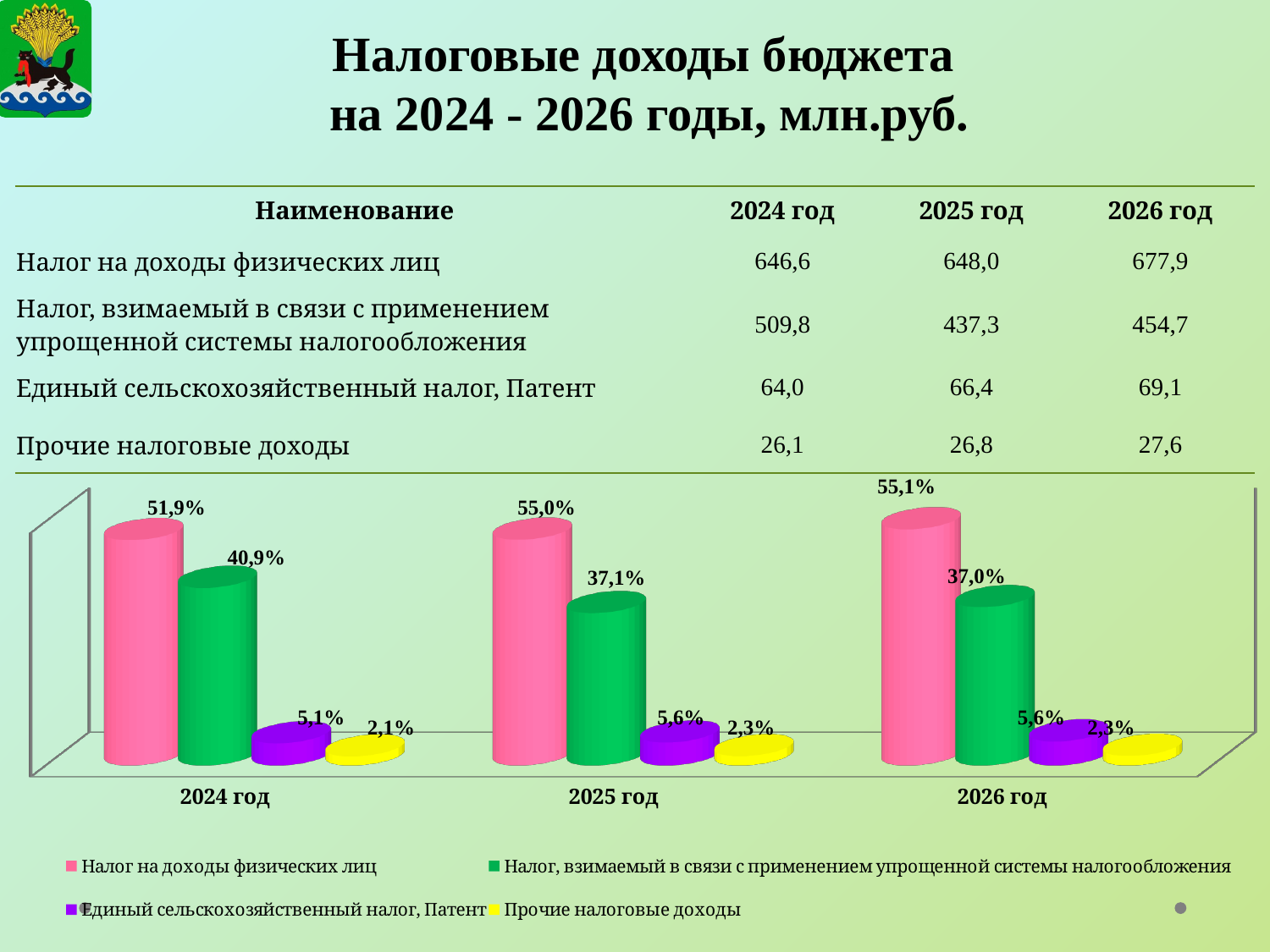
What is the difference between the values for 'Налог на доходы физических лиц' and 'Налог, взимаемый в связи с применением упрощенной системы налогообложения' in 2024 год on the chart? 11,0% How many year categories are shown on the x axis of the chart? 3 What is the value shown for 'Единый сельскохозяйственный налог, Патент' in 2026 год on the chart? 5,6% On the chart, is the value for 'Налог на доходы физических лиц' larger in 2024 год or in 2025 год? 2025 год What kind of chart is shown on the slide? Bar chart What is the value shown for 'Налог на доходы физических лиц' in 2024 год on the chart? 51,9% What is the value shown for 'Налог, взимаемый в связи с применением упрощенной системы налогообложения' in 2025 год on the chart? 37,1% Which series has the lowest value in 2026 год on the chart? Прочие налоговые доходы What is the value shown for 'Прочие налоговые доходы' in 2024 год on the chart? 2,1% Does the value for 'Налог, взимаемый в связи с применением упрощенной системы налогообложения' rise or fall from 2024 год to 2026 год on the chart? Fall How many series does the chart legend list? 4 Which series has the highest value in 2025 год on the chart? Налог на доходы физических лиц